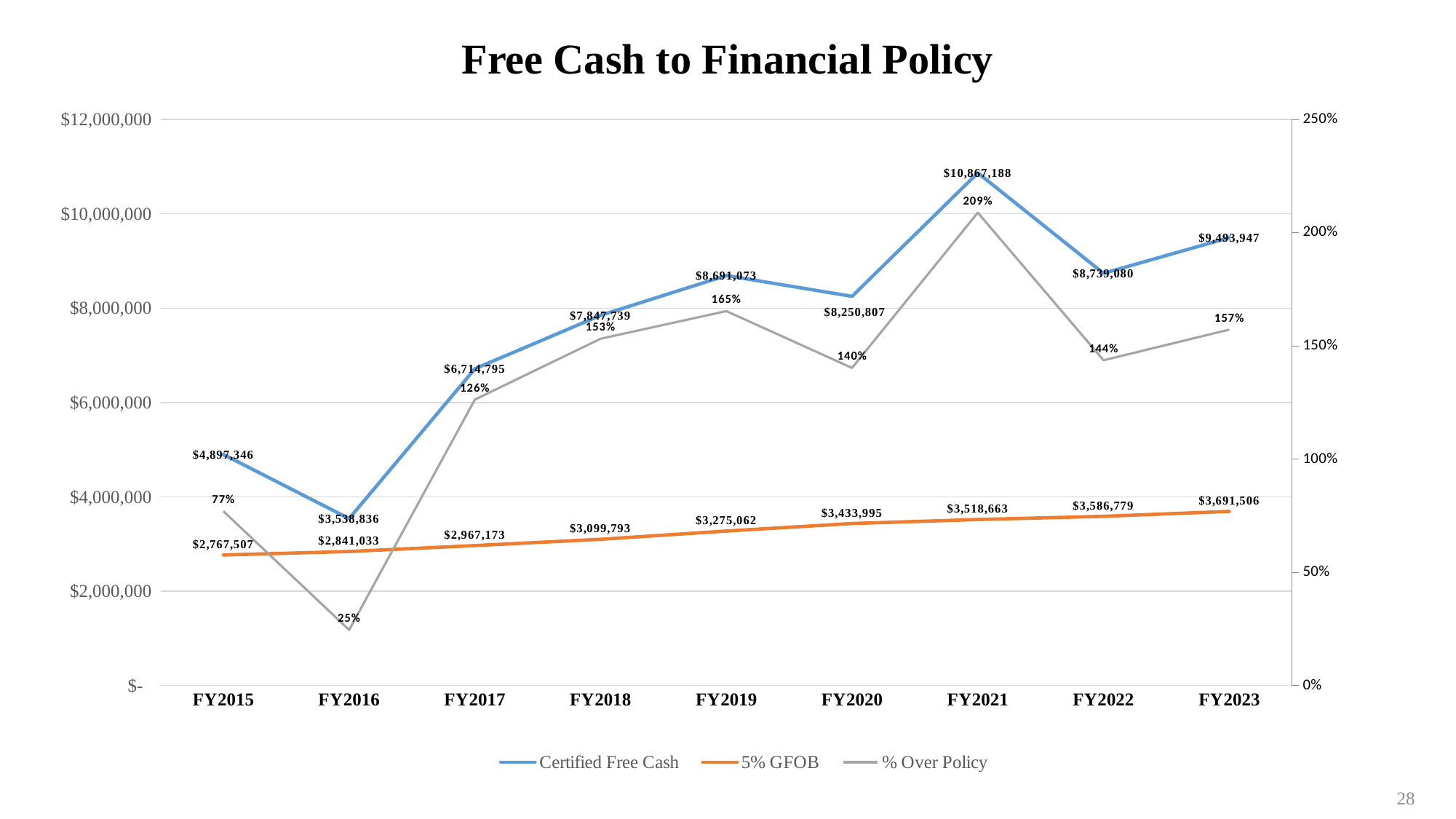
What is the 5% GFOB value for FY2018? $3,099,793 Does the 5% GFOB series rise or fall from FY2015 to FY2023? Rise What is the title of the chart? Free Cash to Financial Policy Which is larger, Certified Free Cash in FY2019 or in FY2020? FY2019 How many series does the legend list? 3 How many fiscal years are shown on the x axis? 9 In which fiscal year is % Over Policy lowest? FY2016 What kind of chart is this? Line chart What is the Certified Free Cash value for FY2021? $10,867,188 What is the difference between Certified Free Cash and 5% GFOB in FY2023? $5,802,441 What is the % Over Policy value for FY2016? 25% In which fiscal year is Certified Free Cash highest? FY2021